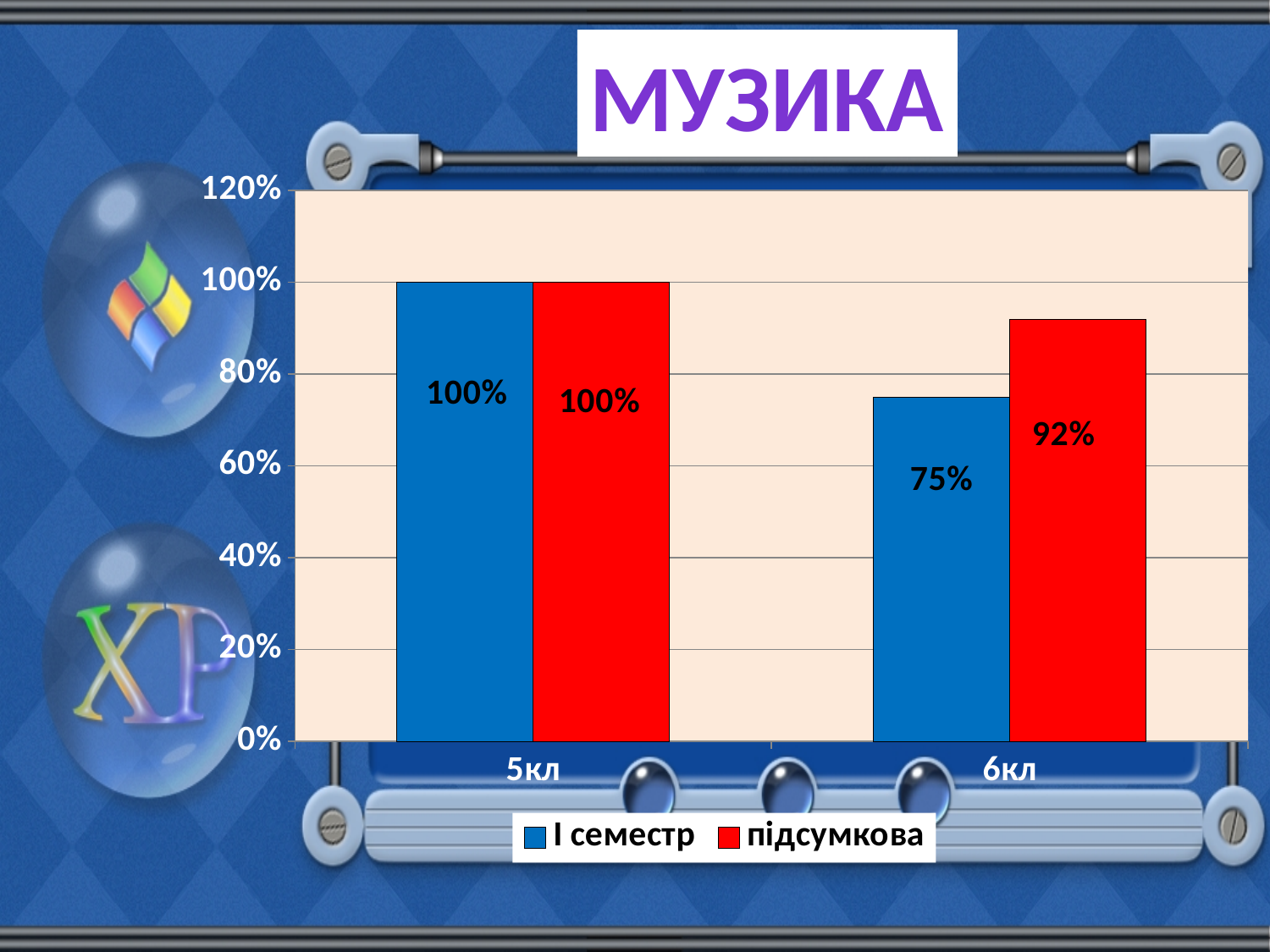
For 6кл, which is larger: the І семестр value or the підсумкова value? підсумкова Which category has the lowest value in the І семестр series? 6кл How many categories are shown on the x axis? 2 What is the value for 6кл in the І семестр series? 75% Which category has the lowest value in the підсумкова series? 6кл What is the title of the chart? МУЗИКА What is the value for 5кл in the І семестр series? 100% What is the value for 6кл in the підсумкова series? 92% What is the difference between the підсумкова and І семестр values for 6кл? 17% What kind of chart is shown on the slide? bar chart How many series does the legend list? 2 What is the value for 5кл in the підсумкова series? 100%